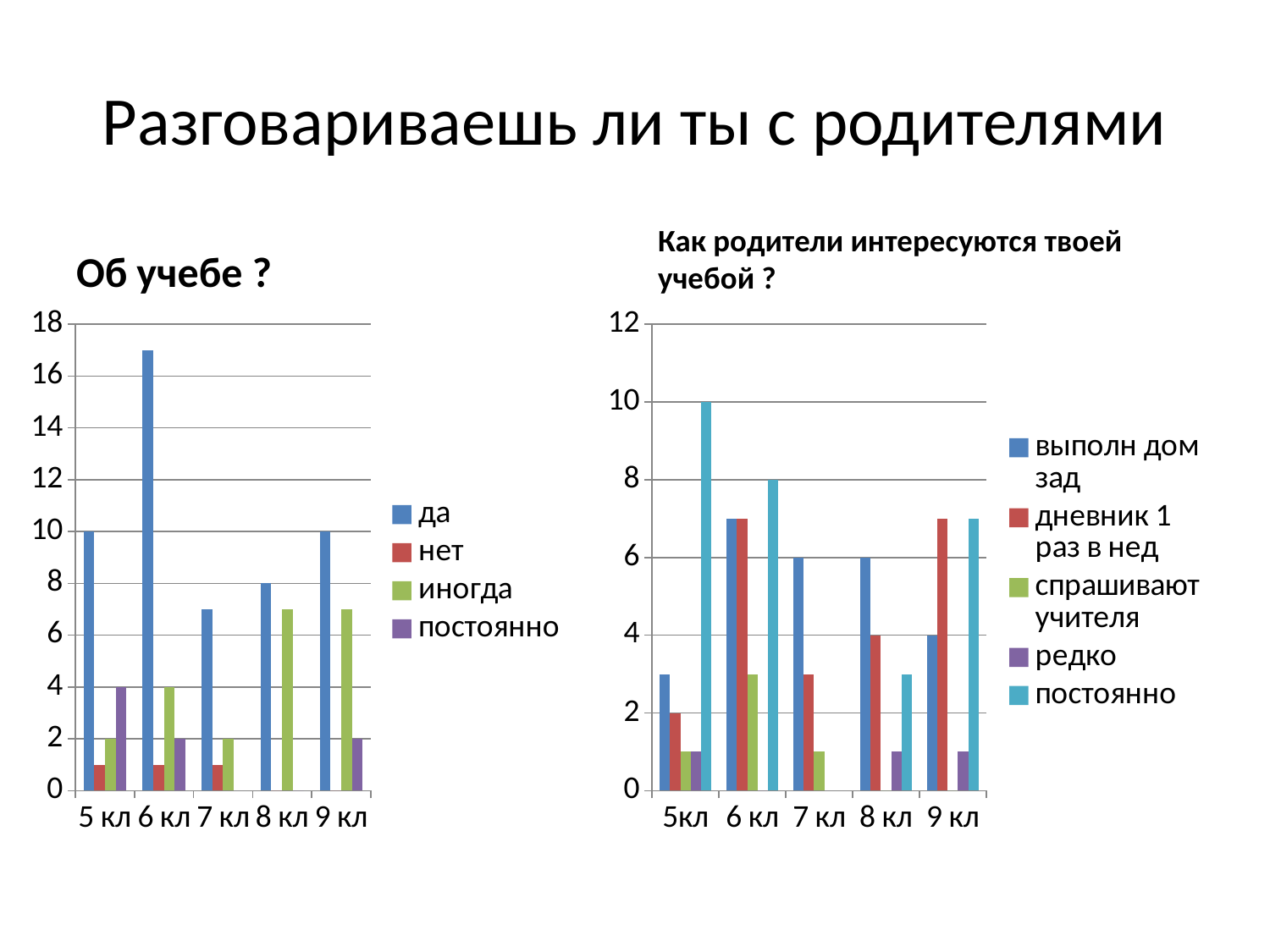
What kind of chart is the left chart titled "Об учебе ?"? bar chart In the left chart "Об учебе ?", what is the difference between "да" for 5 кл and "да" for 8 кл? 2 How many class categories are shown on the x axis of the left chart "Об учебе ?"? 5 In the right chart "Как родители интересуются твоей учебой ?", what is the value of "постоянно" for 5кл? 10 In the right chart "Как родители интересуются твоей учебой ?", which class has the highest value for "постоянно"? 5кл How many series does the legend of the right chart "Как родители интересуются твоей учебой ?" list? 5 In the left chart "Об учебе ?", which class has the highest value for "да"? 6 кл In the left chart "Об учебе ?", is the value of "да" for 6 кл greater or less than 16? greater In the left chart "Об учебе ?", what is the value of "да" for 8 кл? 8 In the left chart "Об учебе ?", what is the value of "да" for 5 кл? 10 In the right chart "Как родители интересуются твоей учебой ?", which is larger for 8 кл: "выполн дом зад" or "дневник 1 раз в нед"? выполн дом зад How many series does the legend of the left chart "Об учебе ?" list? 4